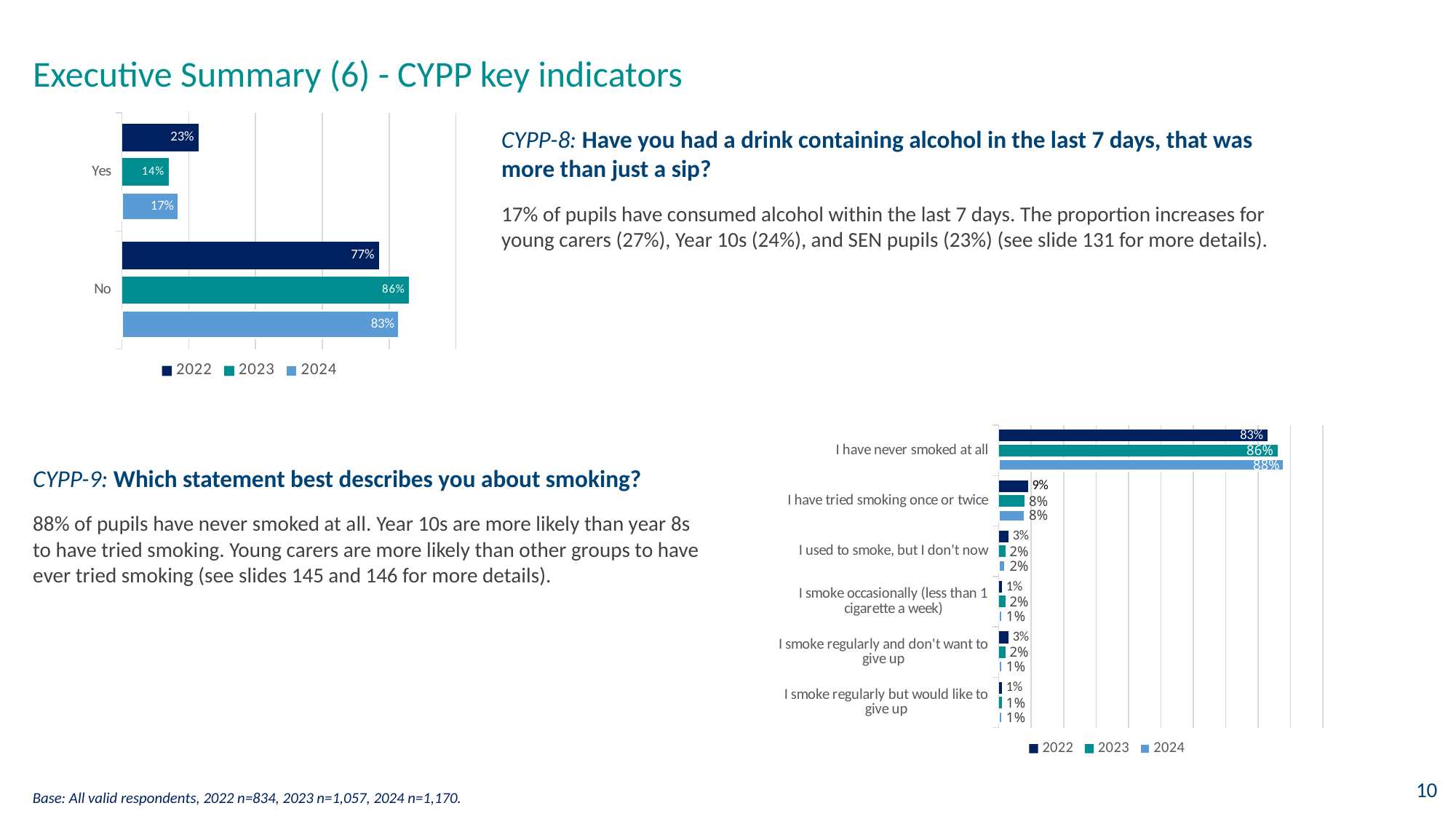
In the bottom-right chart, what is the difference between the 2024 and 2022 values for 'I have never smoked at all'? 5% In the top-left chart, which year has the highest value for Yes? 2022 In the bottom-right chart, what is the 2024 value for 'I have never smoked at all'? 88% In the bottom-right chart, what is the 2022 value for 'I have tried smoking once or twice'? 9% In the top-left chart, what is the 2023 value for No? 86% What kind of chart is the top-left chart? Bar chart In the top-left chart, what is the 2024 value for Yes? 17% In the top-left chart, what is the difference between the 2022 and 2023 values for Yes? 9% In the bottom-right chart, how many statement categories are shown? 6 In the top-left chart, how many series does the legend list? 3 In the bottom-right chart, which is larger for 'I smoke regularly and don't want to give up': the 2022 value or the 2024 value? 2022 In the bottom-right chart, which statement has the highest value in 2023? I have never smoked at all